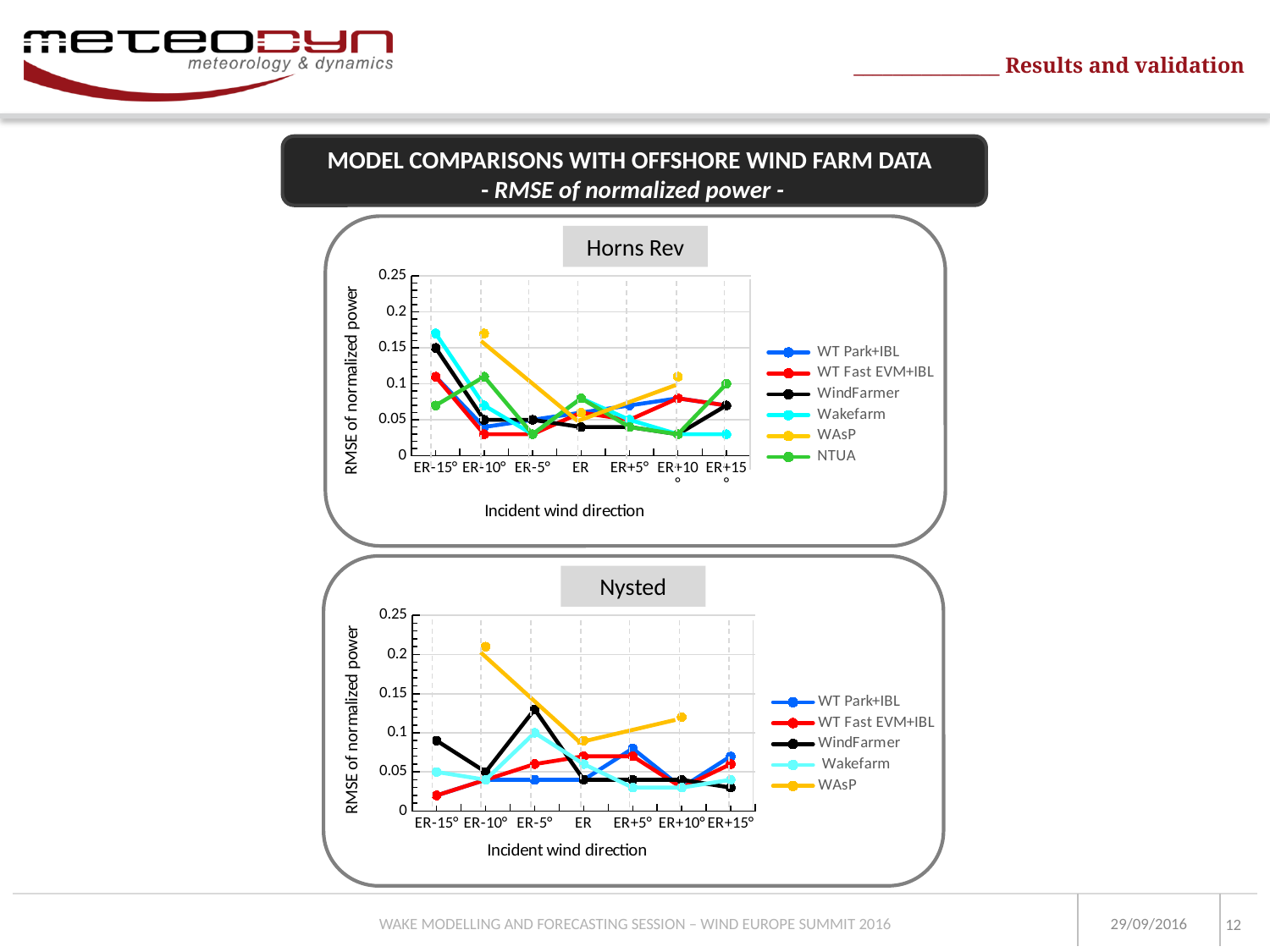
What type of chart is the Horns Rev chart? line chart How many incident wind direction categories are shown on the x axis of the Nysted chart? 7 In the Nysted chart, is the value for WAsP at ER-10° greater or less than 0.2? greater How many series does the legend of the Nysted chart list? 5 In the Nysted chart, which series has the highest RMSE value at ER-10°? WAsP In the Nysted chart, is the value for WindFarmer at ER-5° greater or less than 0.1? greater What is the label of the y axis on the Nysted chart? RMSE of normalized power In the Horns Rev chart, is the value for WAsP at ER-10° greater or less than 0.15? greater How many series does the legend of the Horns Rev chart list? 6